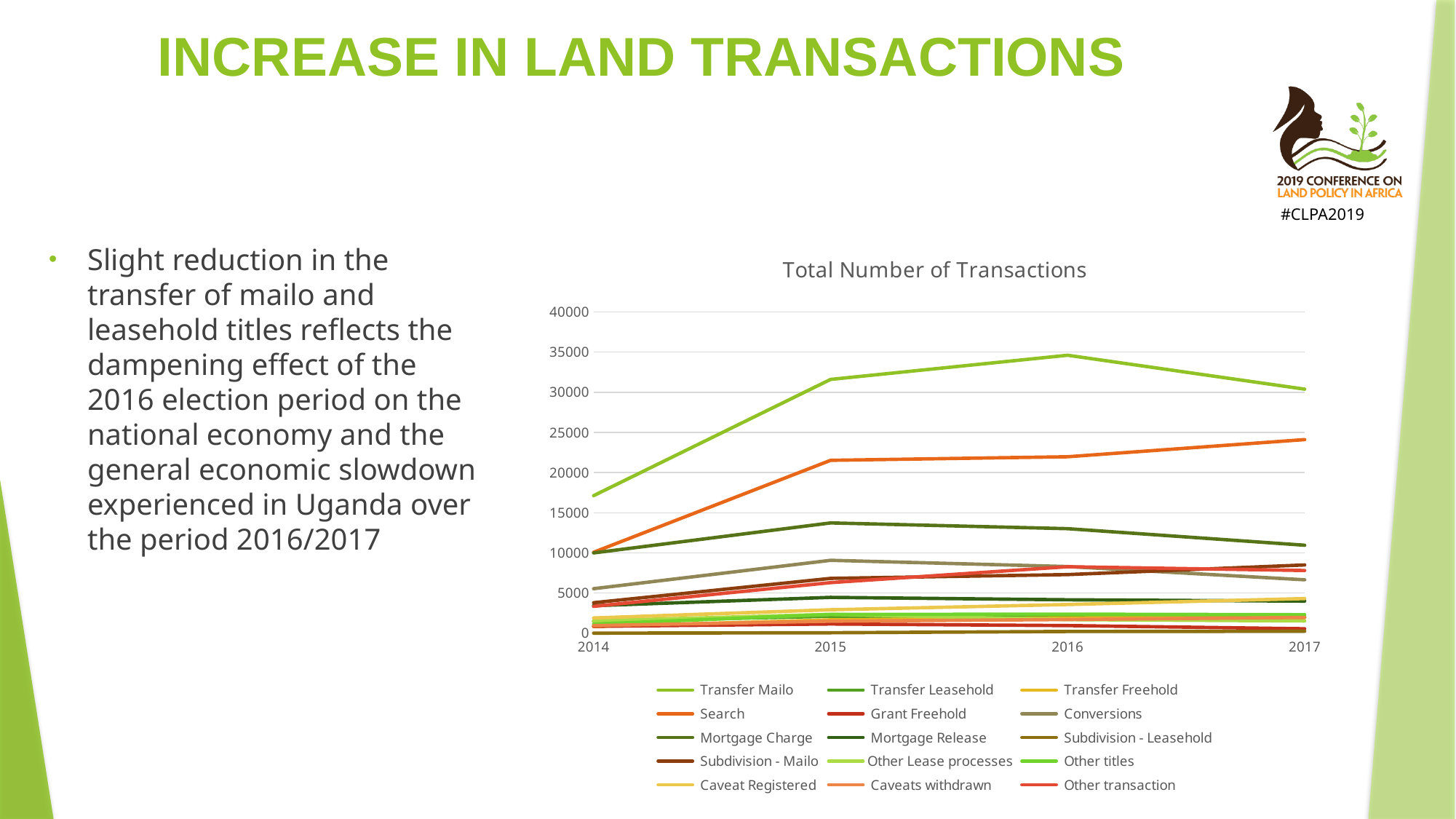
Is the value for Search in 2015 greater or less than 20000? greater How many series does the chart's legend list? 15 In which year does the Transfer Mailo series reach its highest value? 2016 Which series has the highest value in 2016? Transfer Mailo What kind of chart is shown on the slide? line chart What is the title of the chart? Total Number of Transactions Is the value for Transfer Mailo in 2014 greater or less than 20000? less How many years are shown on the x axis of the chart? 4 Does the Search series rise or fall from 2014 to 2017? rises Is the value for Transfer Mailo in 2016 greater or less than 30000? greater In 2017, which is larger: Transfer Mailo or Search? Transfer Mailo